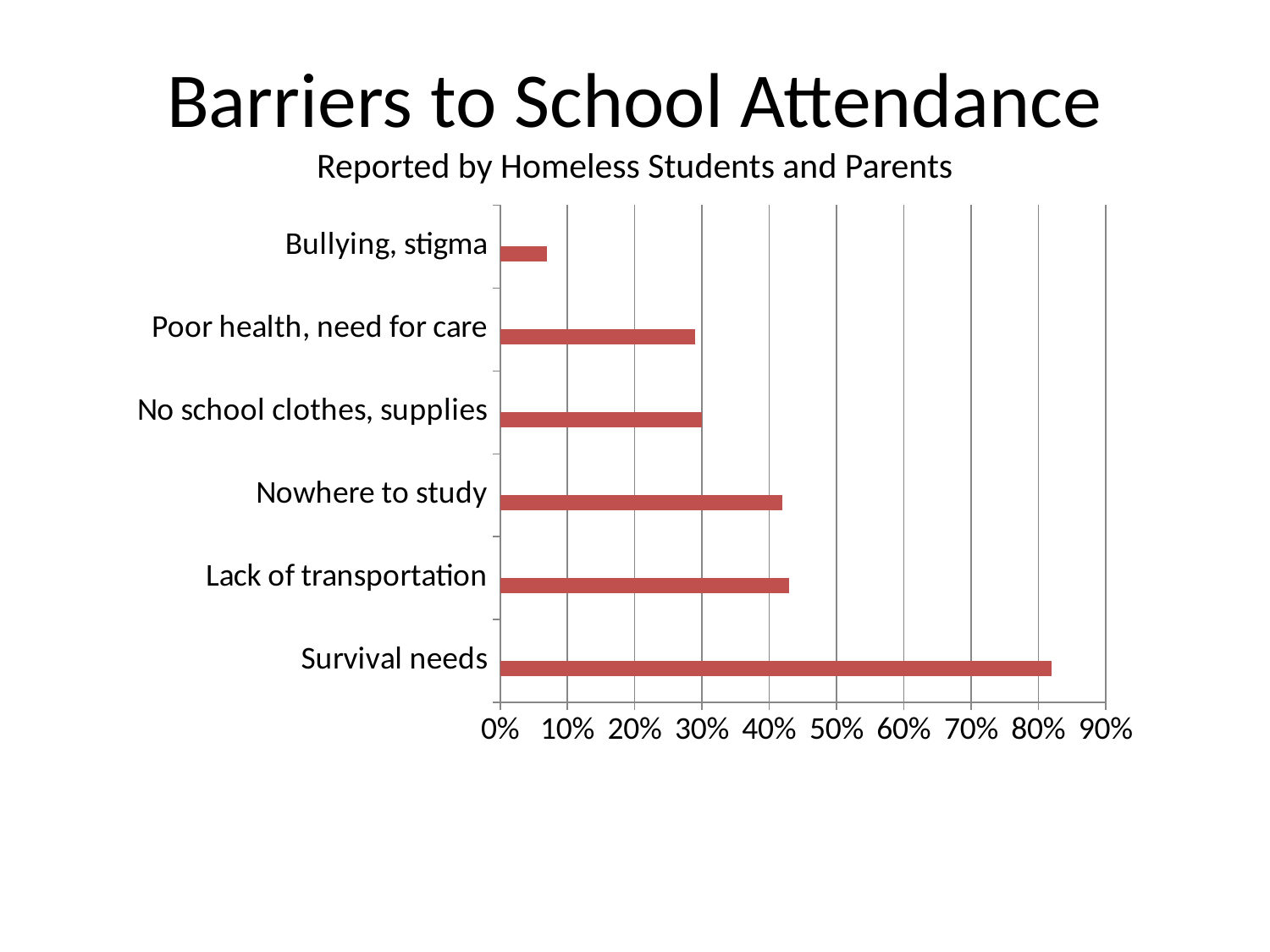
Which is larger, the value for Survival needs or the value for Nowhere to study? Survival needs Is the value for Survival needs greater or less than 70%? greater What kind of chart is shown on the slide? Bar chart Is the value for Nowhere to study greater or less than 40%? greater What is the title of the chart on the slide? Barriers to School Attendance How many barriers (categories) are plotted in the chart? 6 Is the value for Bullying, stigma greater or less than 10%? less Which barrier has the highest value in the chart? Survival needs Which is larger, the value for Bullying, stigma or the value for Poor health, need for care? Poor health, need for care Which barrier has the lowest value in the chart? Bullying, stigma